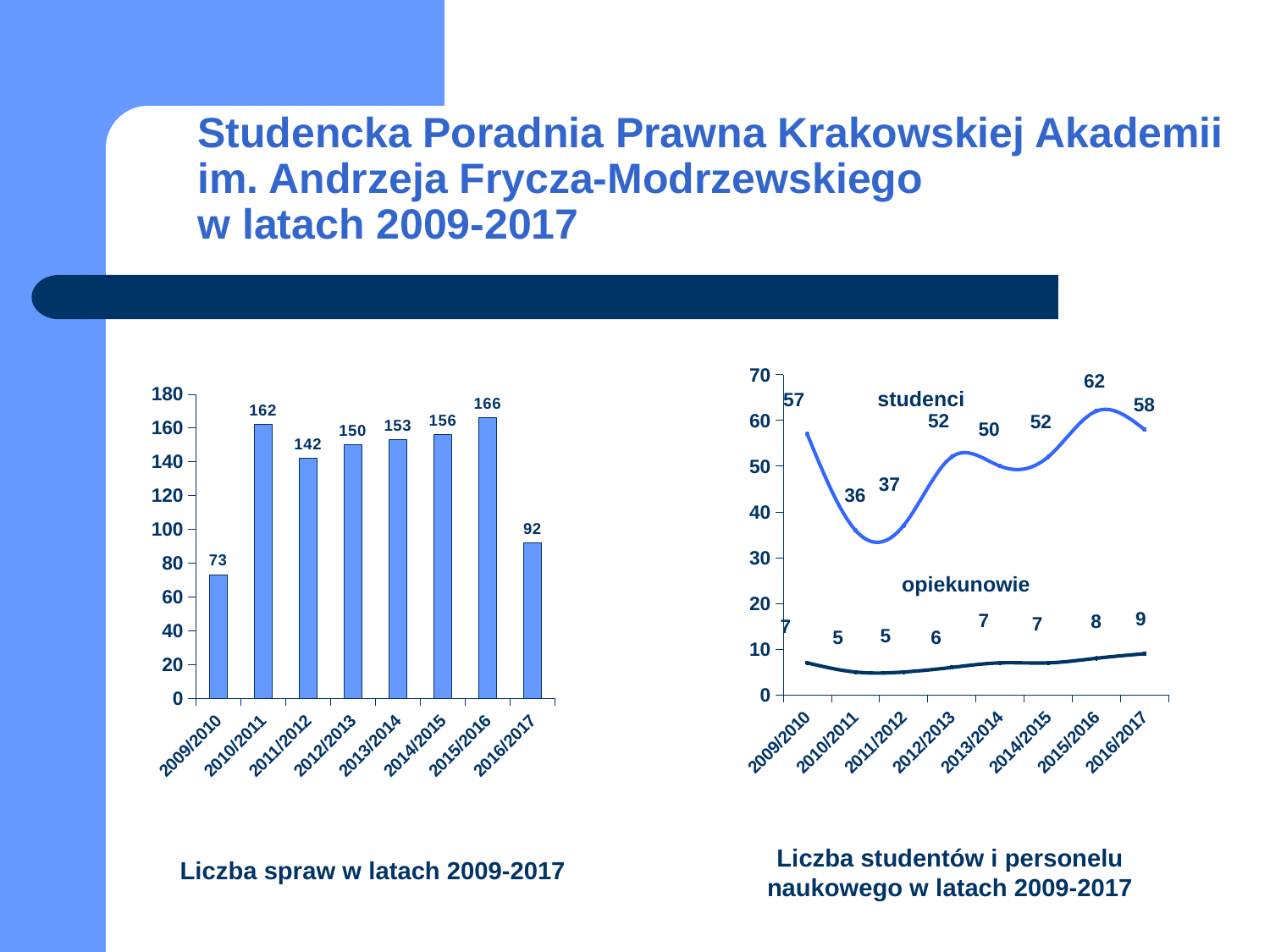
In the right chart (Liczba studentów i personelu naukowego), in which year is the studenci value lowest? 2010/2011 In the right chart (Liczba studentów i personelu naukowego), what is the value for opiekunowie in 2016/2017? 9 In the left chart (Liczba spraw w latach 2009-2017), which year has the highest value? 2015/2016 What kind of chart is the left chart (Liczba spraw w latach 2009-2017)? bar chart In the left chart (Liczba spraw w latach 2009-2017), what is the difference between the values for 2015/2016 and 2016/2017? 74 In the right chart (Liczba studentów i personelu naukowego), what is the value for studenci in 2015/2016? 62 In the left chart (Liczba spraw w latach 2009-2017), which year has the lowest value? 2009/2010 In the right chart (Liczba studentów i personelu naukowego), which is larger: the studenci value in 2012/2013 or in 2013/2014? 2012/2013 In the right chart (Liczba studentów i personelu naukowego), what is the difference between studenci and opiekunowie in 2009/2010? 50 What kind of chart is the right chart (Liczba studentów i personelu naukowego)? line chart In the left chart (Liczba spraw w latach 2009-2017), what is the value for 2010/2011? 162 In the left chart (Liczba spraw w latach 2009-2017), how many years are shown on the x axis? 8